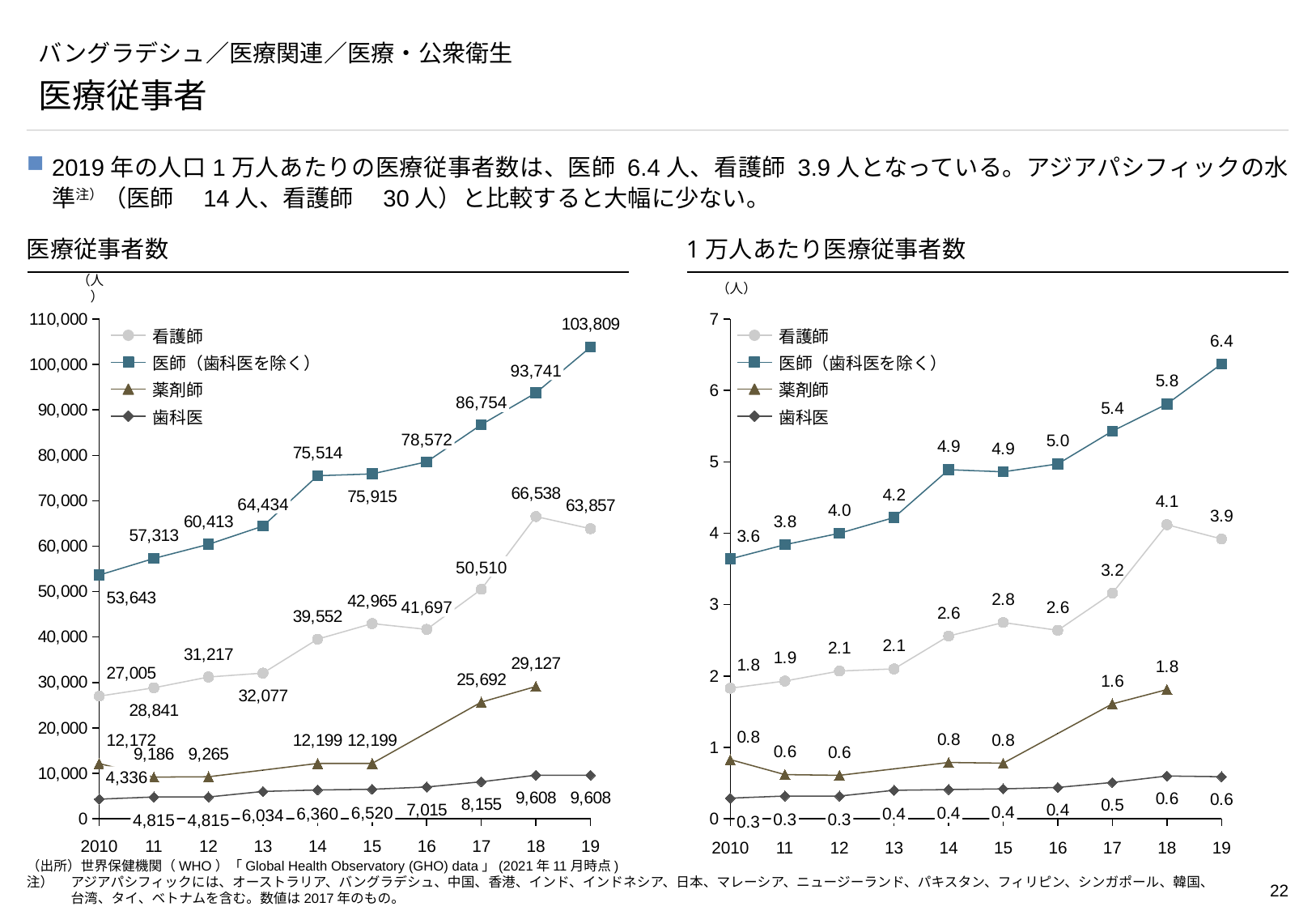
What kind of chart is the 1万人あたり医療従事者数 chart on the right? line chart In the 1万人あたり医療従事者数 chart on the right, does the 医師（歯科医を除く） series generally rise or fall from 2010 to 2019? rise In the 1万人あたり医療従事者数 chart on the right, what is the value for 医師（歯科医を除く） in 2019? 6.4 In the 医療従事者数 chart on the left, what is the value for 看護師 in 2018? 66,538 In the 1万人あたり医療従事者数 chart on the right, is the 看護師 value in 2018 larger or smaller than in 2019? larger In the 1万人あたり医療従事者数 chart on the right, what is the value for 薬剤師 in 2018? 1.8 In the 1万人あたり医療従事者数 chart on the right, what is the value for 看護師 in 2019? 3.9 In the 医療従事者数 chart on the left, how many series does the legend list? 4 In the 医療従事者数 chart on the left, what is the value for 医師（歯科医を除く） in 2019? 103,809 In the 医療従事者数 chart on the left, what is the value for 歯科医 in 2010? 4,336 In the 医療従事者数 chart on the left, which series has the highest value in 2019? 医師（歯科医を除く） In the 医療従事者数 chart on the left, what is the difference between the 医師（歯科医を除く） values in 2019 and 2018? 10,068